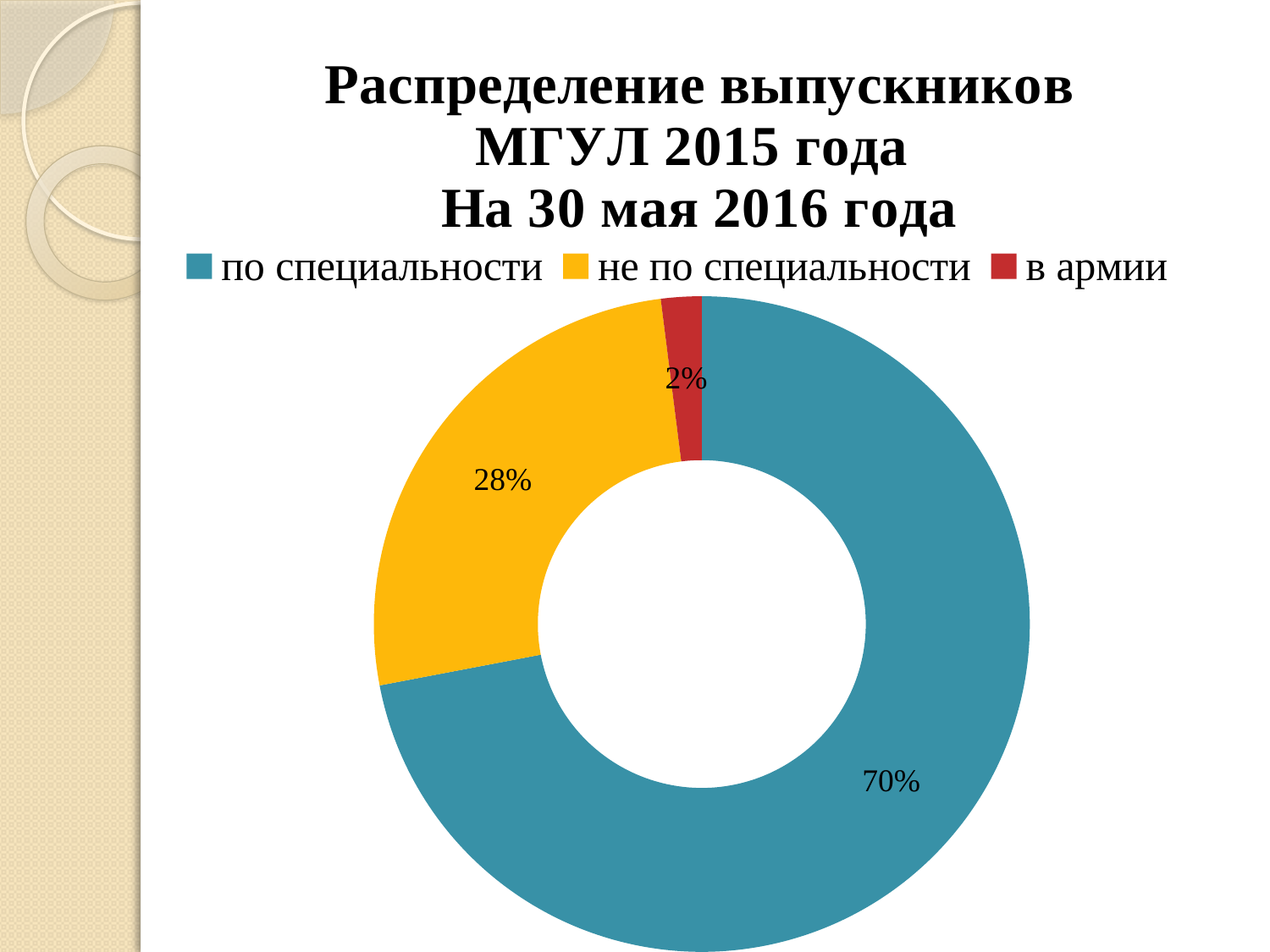
What is the difference in percentage points between "по специальности" and "не по специальности"? 42 What share of graduates is shown for "не по специальности"? 28% Which category has the largest share of the chart? по специальности What kind of chart is shown on the slide? Doughnut (pie) chart How many entries does the legend list? 3 What is the title of the chart? Распределение выпускников МГУЛ 2015 года На 30 мая 2016 года Which is larger: the share for "не по специальности" or the share for "в армии"? не по специальности What share of graduates is shown for "в армии"? 2% How many categories does the chart show? 3 Which category has the smallest share of the chart? в армии What share of graduates is shown for "по специальности"? 70% What colour is the slice for "в армии"? Red